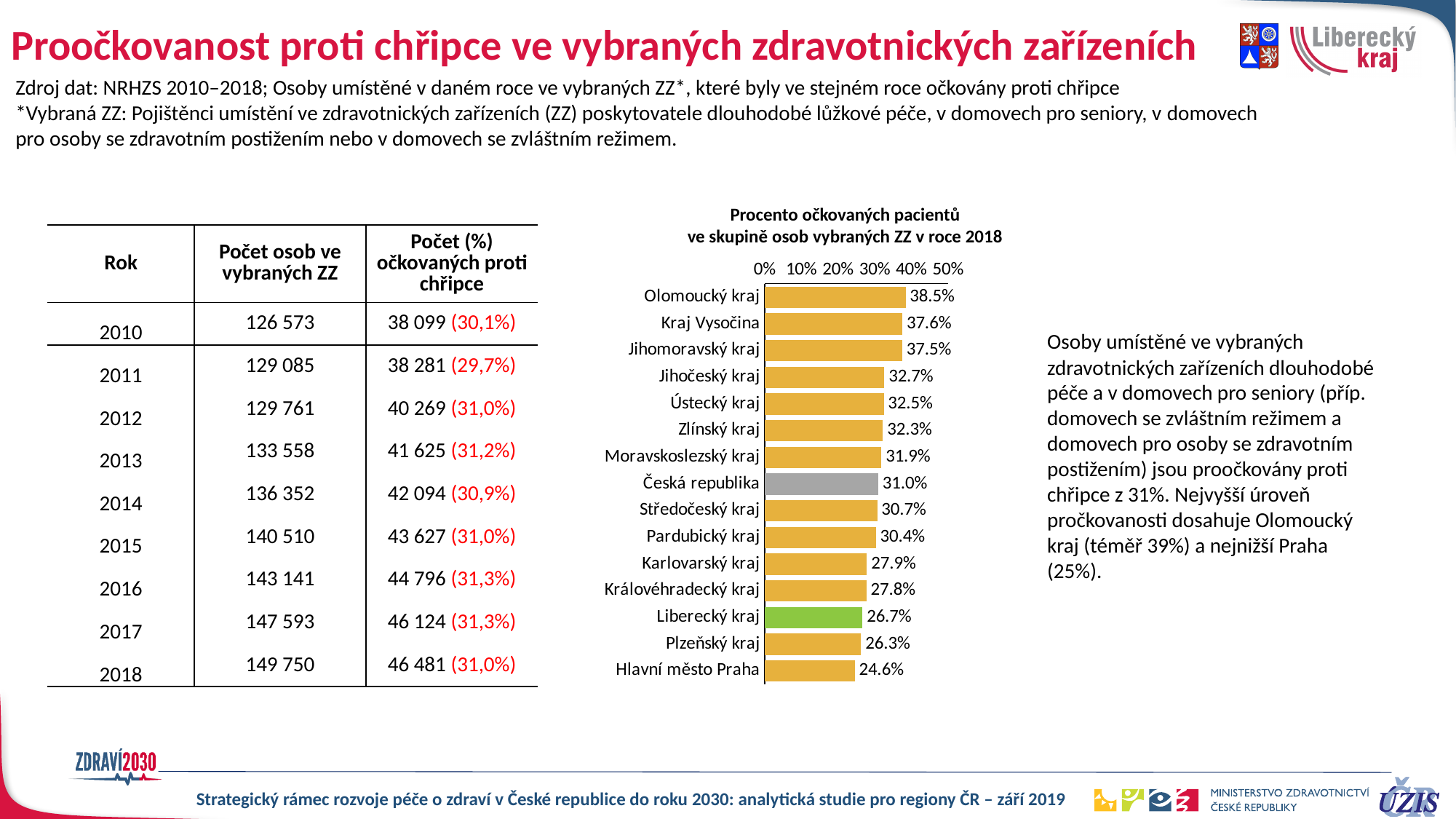
Which category has the lowest value? Hlavní město Praha Which is larger, the value for Jihočeský kraj or the value for Plzeňský kraj? Jihočeský kraj What is the difference between the values for Olomoucký kraj and Hlavní město Praha? 13.9 percentage points Which category has the highest value? Olomoucký kraj What is the value for Česká republika? 31.0% What is the value for Olomoucký kraj? 38.5% Is the value for Kraj Vysočina greater or less than 30%? greater What kind of chart is shown on the slide? bar chart What is the value for Liberecký kraj? 26.7% Which category's bar is coloured green? Liberecký kraj How many categories are shown in the chart? 15 What is the difference between the values for Česká republika and Liberecký kraj? 4.3 percentage points